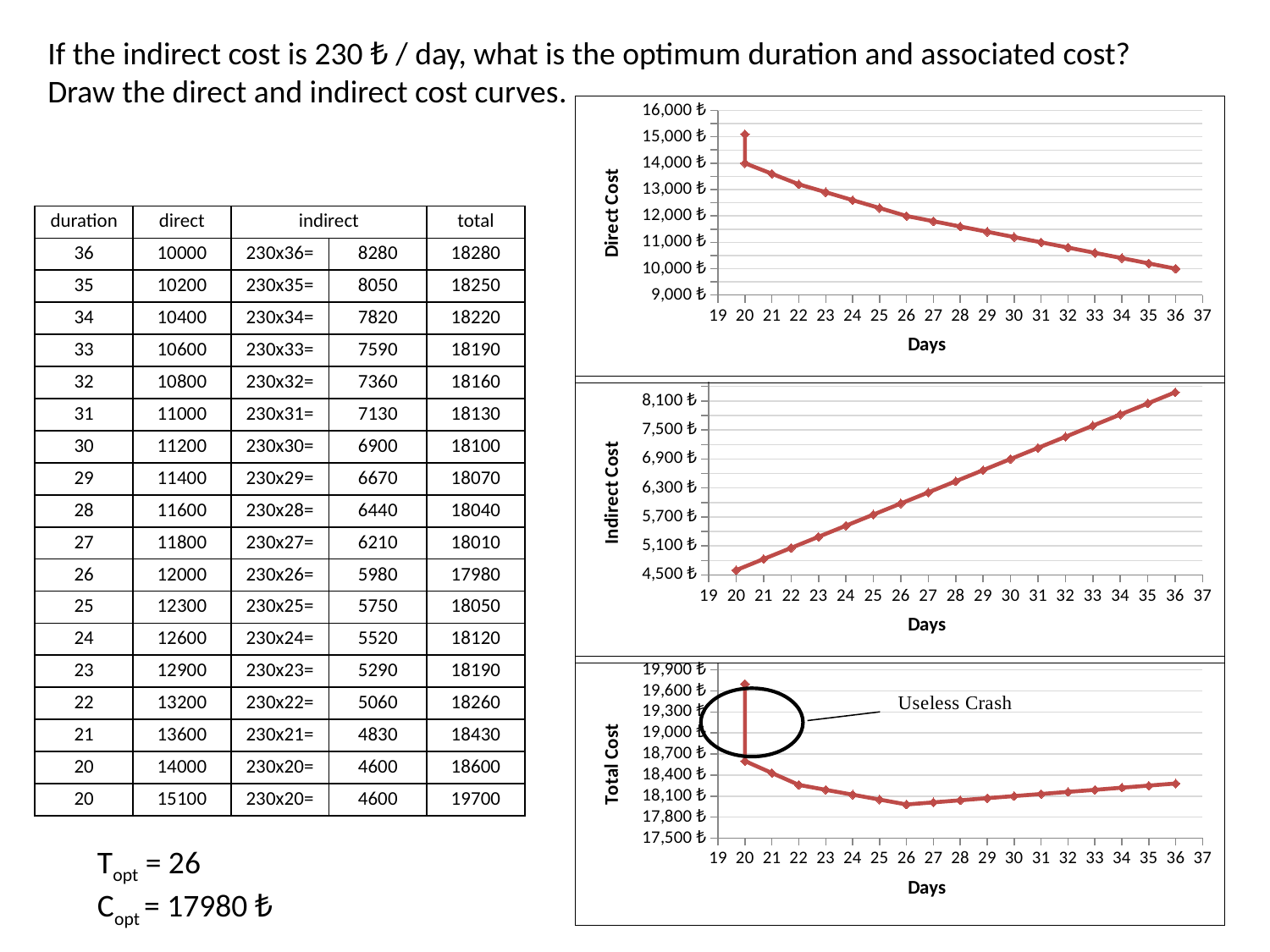
What is the x-axis title of the Total Cost chart? Days In the Direct Cost chart, is the value at 33 days greater or less than 11,000 ₺? less What kind of chart is the Direct Cost chart? line chart In the Direct Cost chart, at how many days is the direct cost highest? 20 How many charts are shown on the slide? 3 In the Direct Cost chart, do the values rise or fall as the number of days increases? fall In the Indirect Cost chart, do the values rise or fall as the number of days increases? rise In the Indirect Cost chart, is the value at 36 days greater or less than 8,100 ₺? greater In the Indirect Cost chart, what is the indirect cost at 30 days? 6,900 ₺ In the Total Cost chart, is the value at 26 days greater or less than 18,100 ₺? less In the Total Cost chart, at how many days is the total cost lowest? 26 In the Direct Cost chart, what is the direct cost at 36 days? 10,000 ₺